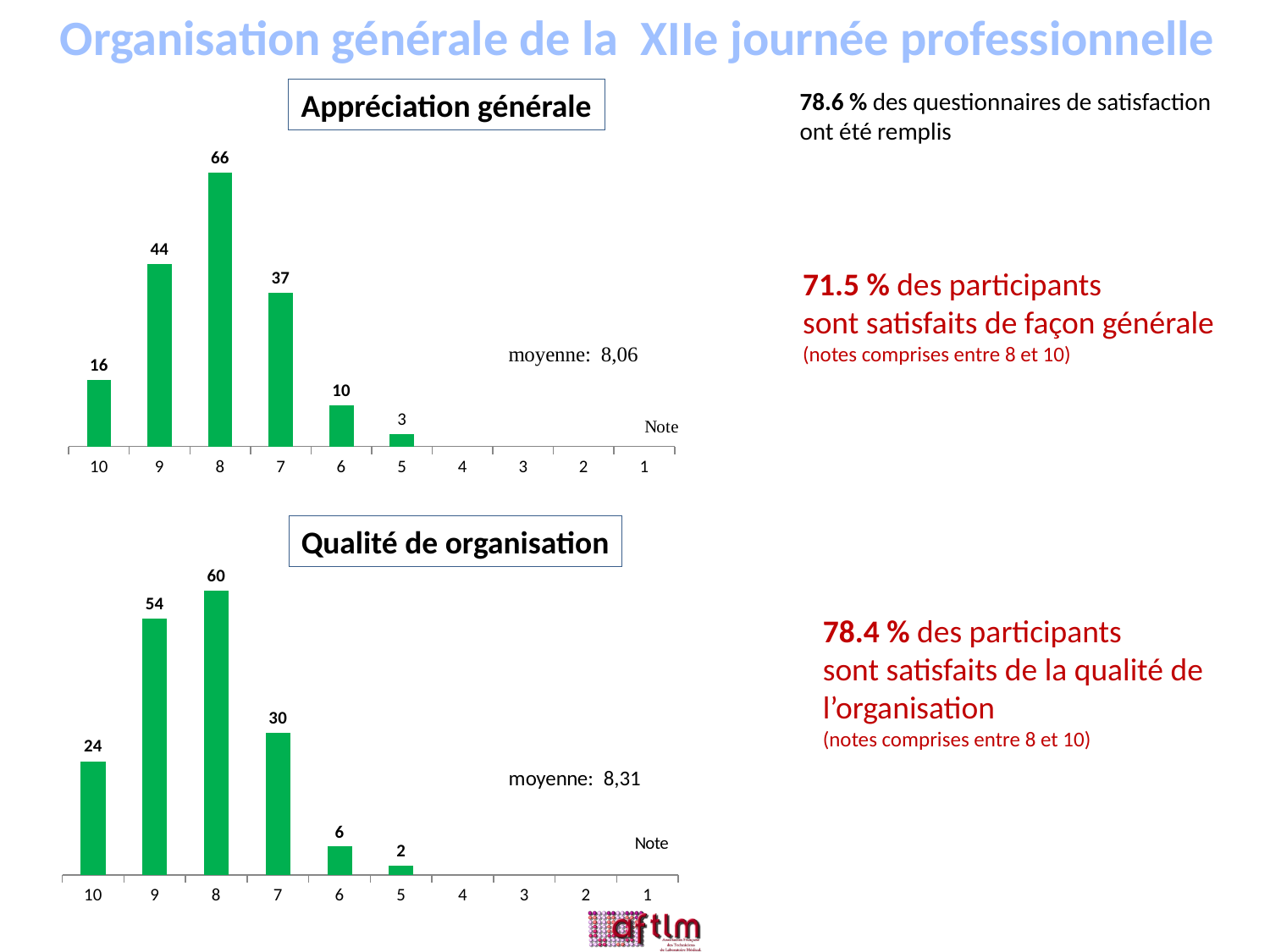
In the 'Qualité de organisation' chart, what is the value for note 9? 54 In the 'Appréciation générale' chart, what is the value for note 8? 66 How many note categories are shown on the x axis of the 'Qualité de organisation' chart? 10 What kind of chart is the 'Appréciation générale' chart? bar chart In the 'Appréciation générale' chart, what is the value for note 10? 16 In the 'Appréciation générale' chart, what is the difference between the values for note 9 and note 7? 7 In the 'Qualité de organisation' chart, what is the difference between the values for note 8 and note 10? 36 In the 'Appréciation générale' chart, which note has the highest value? 8 In the 'Appréciation générale' chart, which is larger, the value for note 6 or the value for note 5? note 6 What average (moyenne) is printed on the 'Qualité de organisation' chart? 8,31 In the 'Qualité de organisation' chart, which note has the highest value? 8 In the 'Qualité de organisation' chart, what is the value for note 5? 2